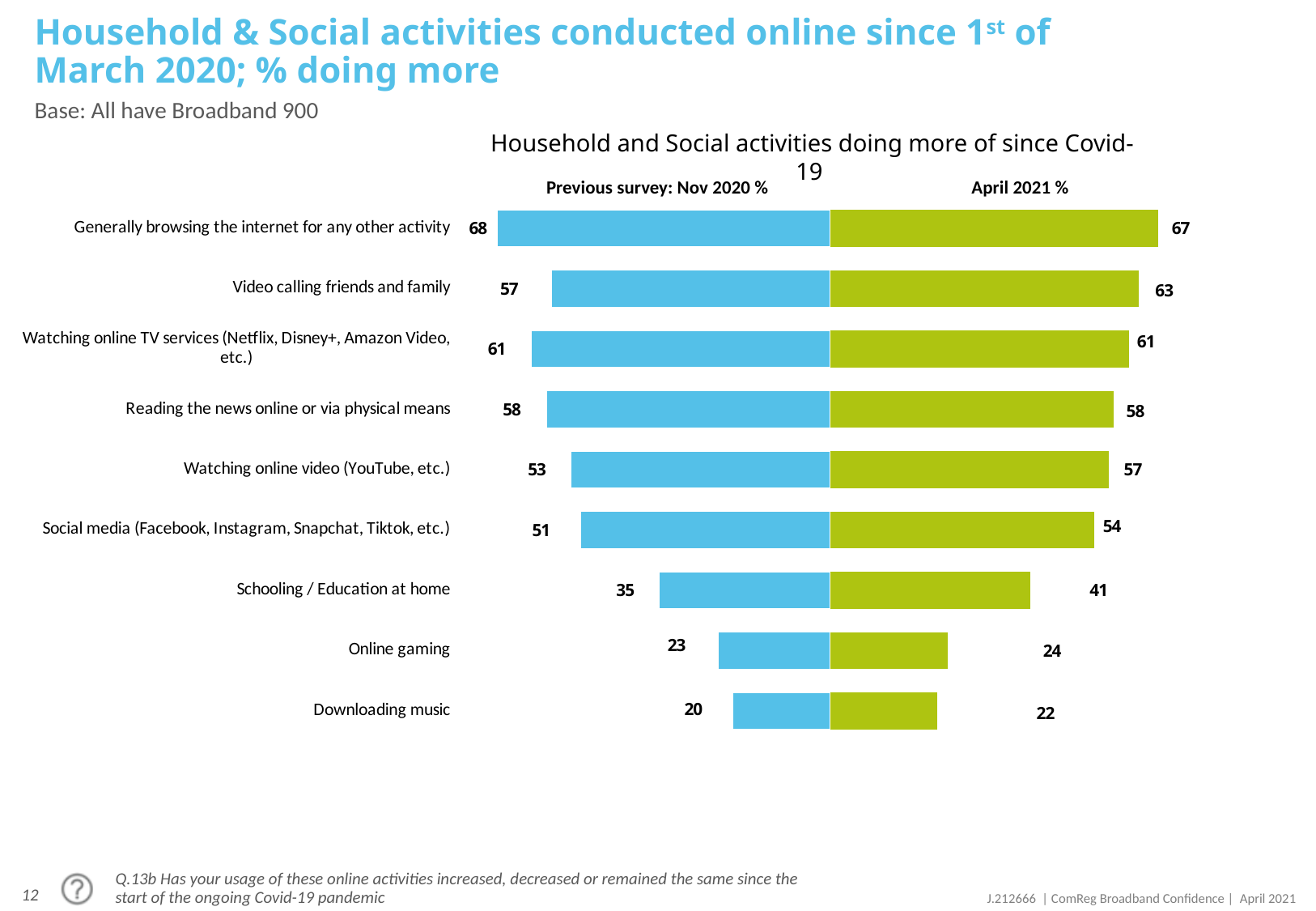
What is the difference between the Nov 2020 % and April 2021 % values for Generally browsing the internet for any other activity? 1 Which activity has the highest April 2021 % value? Generally browsing the internet for any other activity Which activity has the lowest Previous survey: Nov 2020 % value? Downloading music How many activities are shown in the chart? 9 What is the April 2021 % value for Video calling friends and family? 63 What is the difference between the April 2021 % and Nov 2020 % values for Schooling / Education at home? 6 What kind of chart is shown on the slide? Bar chart What is the Nov 2020 % value for Online gaming? 23 How many series does the chart show? 2 What is the Previous survey: Nov 2020 % value for Schooling / Education at home? 35 Which colour represents the April 2021 % series? Green Which is larger for Watching online video (YouTube, etc.): the Nov 2020 % value or the April 2021 % value? April 2021 %